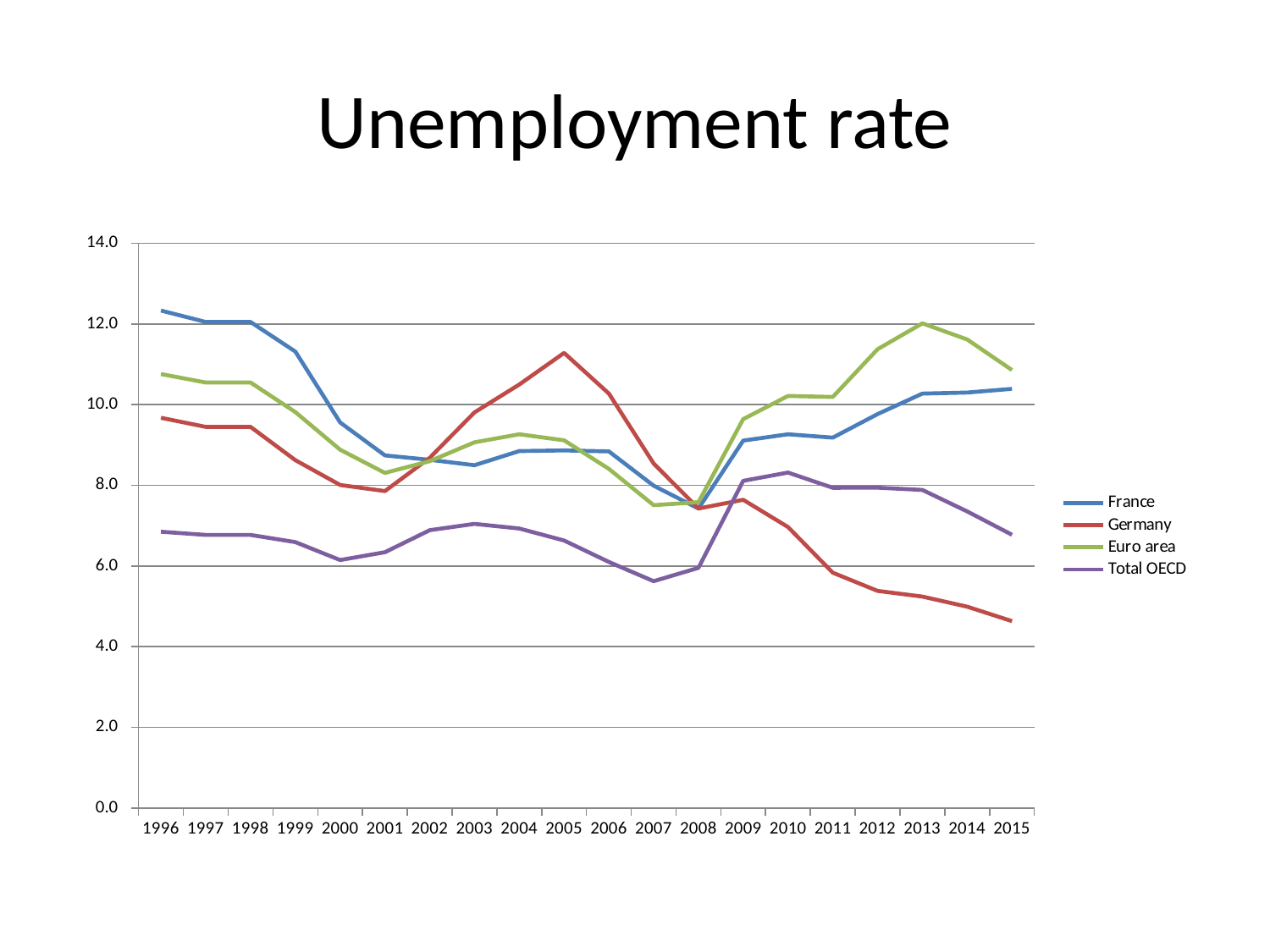
What kind of chart is shown on the slide? line chart Which series has the highest value in 2013? Euro area How many series does the legend list? 4 Which series has the lowest value in 1996? Total OECD How many years are shown along the x axis? 20 In which year does the Germany series reach its highest value? 2005 What is the title of the chart? Unemployment rate In 2015, which is larger, the value for France or the value for Germany? France Is the value for France in 1996 greater or less than 10.0? greater In 2005, which is larger, the value for Germany or the value for France? Germany Is the value for Germany in 2015 greater or less than 6.0? less Is the value for Euro area in 2013 greater or less than 10.0? greater